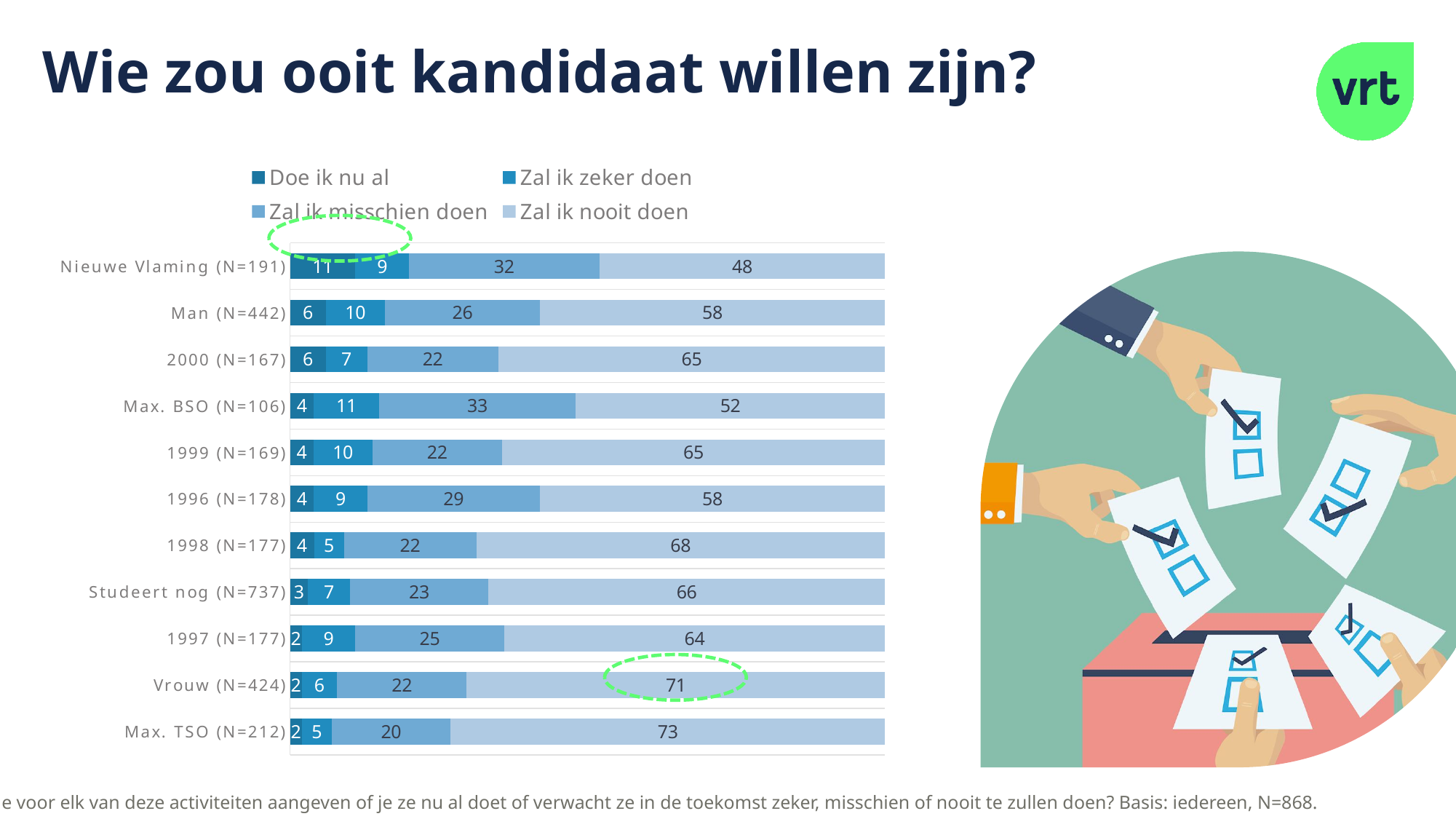
How many series does the legend list? 4 What kind of chart is shown on the slide? Stacked bar chart What is the value of "Doe ik nu al" for Nieuwe Vlaming (N=191)? 11 Which has a larger "Zal ik zeker doen" value, Man (N=442) or Vrouw (N=424)? Man (N=442) What is the difference between the "Zal ik nooit doen" values for Max. TSO (N=212) and Nieuwe Vlaming (N=191)? 25 What is the total of the stacked bar for 1998 (N=177)? 99 Which legend entry is listed first in the chart legend? Doe ik nu al Which category has the lowest value for "Zal ik nooit doen"? Nieuwe Vlaming (N=191) Which category has the highest value for "Zal ik nooit doen"? Max. TSO (N=212) How many categories are plotted in the chart? 11 What is the value of "Zal ik misschien doen" for Max. BSO (N=106)? 33 What is the value of "Zal ik nooit doen" for Vrouw (N=424)? 71